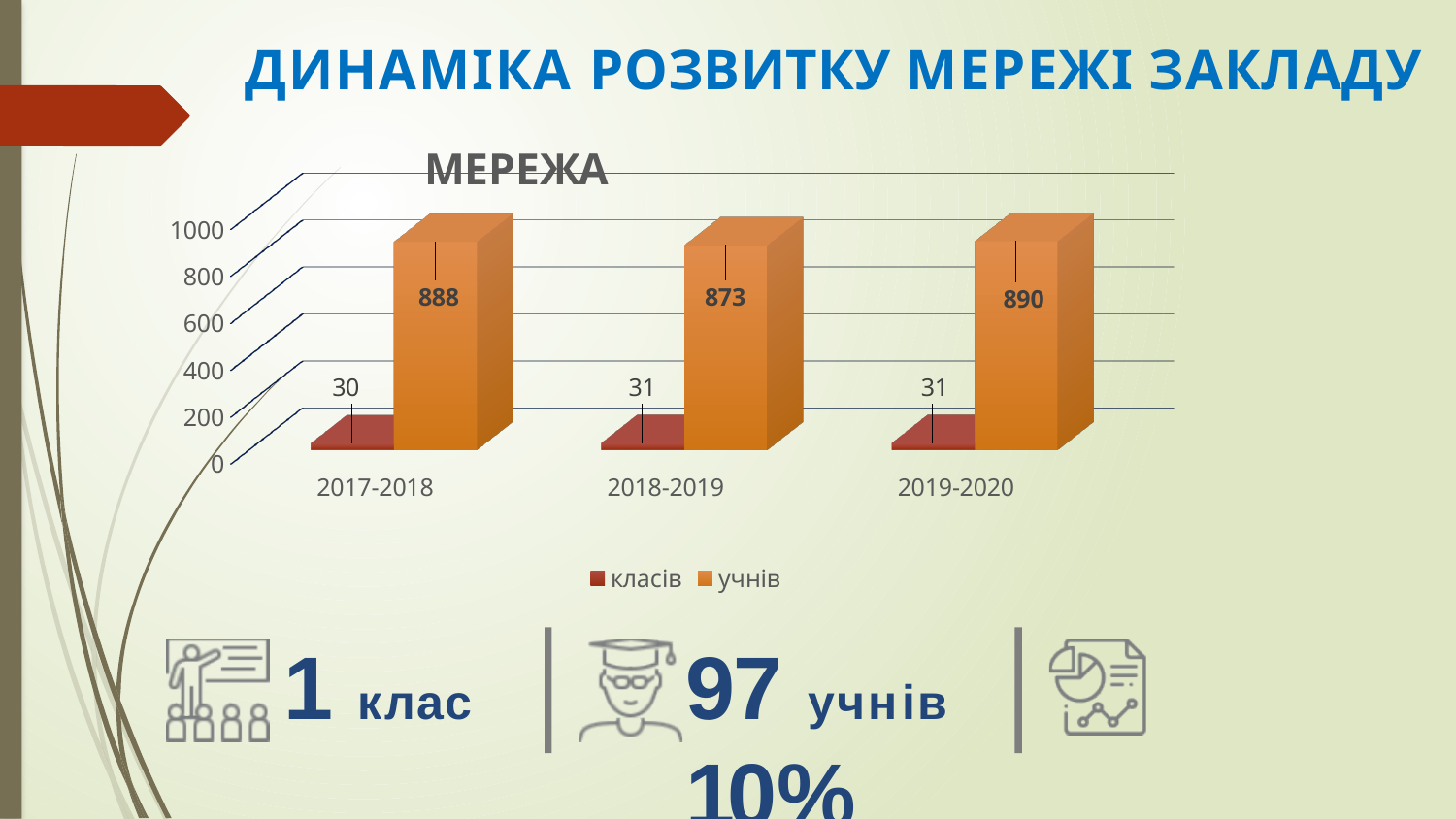
Which year has the highest value for учнів? 2019-2020 What kind of chart is shown? bar chart What is the title of the chart? МЕРЕЖА How many series does the legend list? 2 What is the value for учнів in 2018-2019? 873 What is the value for учнів in 2017-2018? 888 What is the value for класів in 2019-2020? 31 Which year has the lowest value for класів? 2017-2018 What is the difference between the учнів values for 2019-2020 and 2018-2019? 17 How many year categories are shown on the x axis? 3 Is the value for учнів in 2019-2020 greater or less than 800? greater Which is larger, the учнів value for 2017-2018 or for 2018-2019? 2017-2018